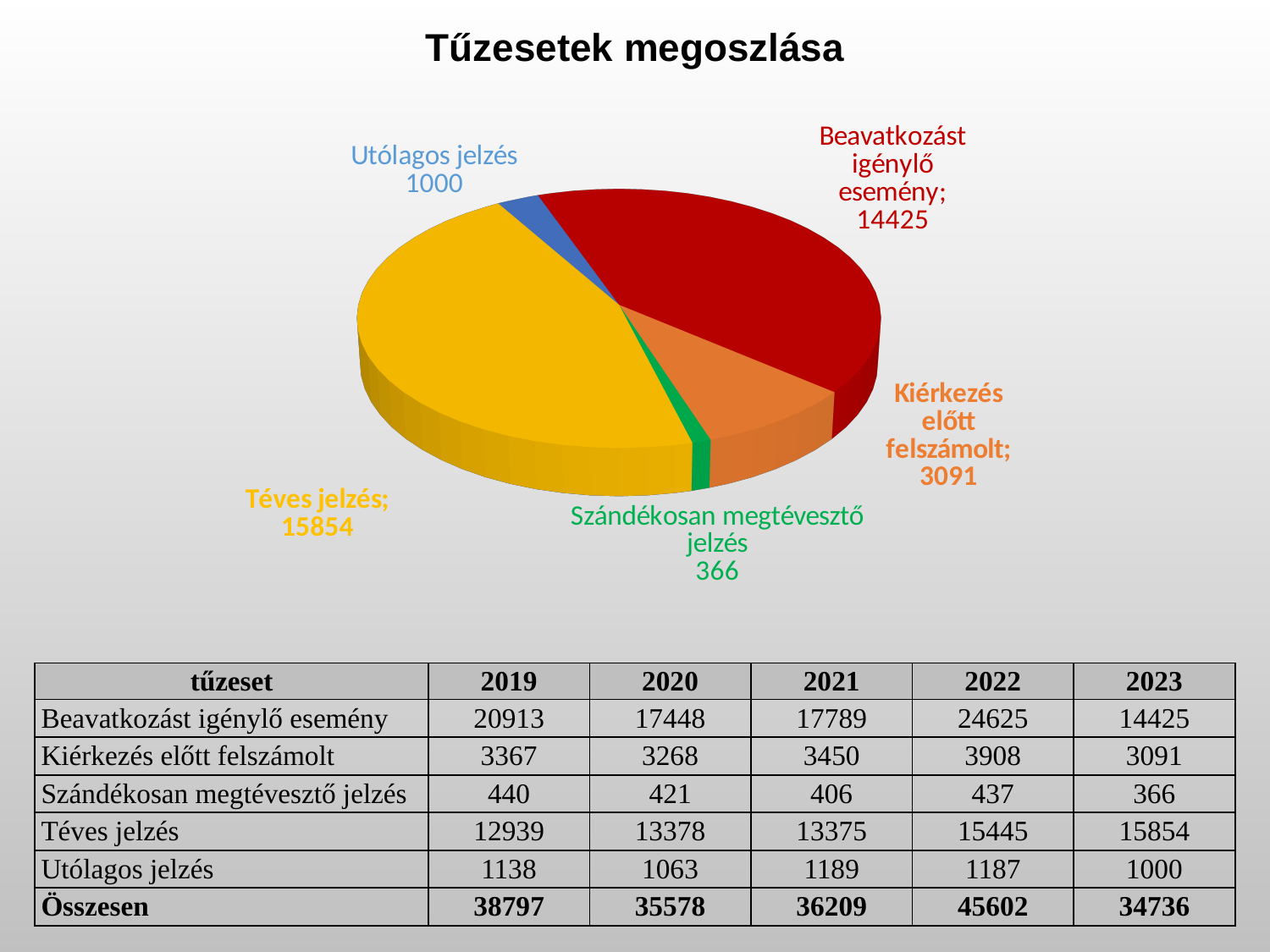
What is the value shown for Szándékosan megtévesztő jelzés in the pie chart? 366 What is the value shown for Téves jelzés in the pie chart? 15854 Which category has the largest slice in the pie chart? Téves jelzés How many slices does the pie chart have? 5 Which is larger in the pie chart, Kiérkezés előtt felszámolt or Utólagos jelzés? Kiérkezés előtt felszámolt Which category has the smallest slice in the pie chart? Szándékosan megtévesztő jelzés What is the value shown for Utólagos jelzés in the pie chart? 1000 What is the title of the chart? Tűzesetek megoszlása What is the value shown for Kiérkezés előtt felszámolt in the pie chart? 3091 What is the value shown for Beavatkozást igénylő esemény in the pie chart? 14425 What type of chart is shown on the slide? pie chart What is the difference between the values for Téves jelzés and Beavatkozást igénylő esemény in the pie chart? 1429